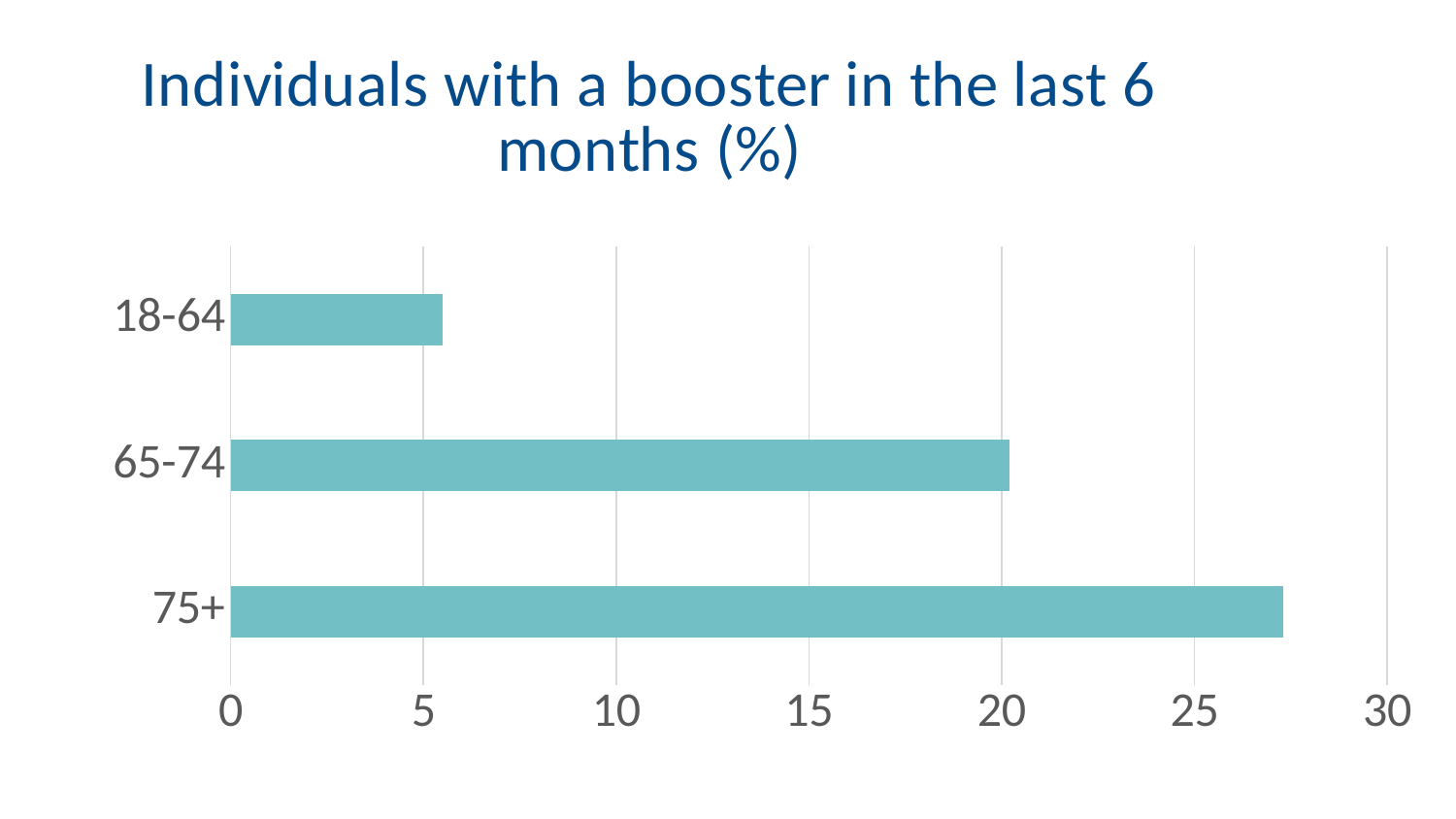
Which age group has a larger value, 75+ or 65-74? 75+ What kind of chart is shown on the slide? bar chart Which age group has a larger value, 65-74 or 18-64? 65-74 Is the value for the 18-64 age group greater or less than 10? less What is the title of the chart? Individuals with a booster in the last 6 months (%) Which age group has the lowest percentage of individuals with a booster in the last 6 months? 18-64 How many age groups are shown in the chart? 3 Is the value for the 65-74 age group greater or less than 15? greater Which age group has the highest percentage of individuals with a booster in the last 6 months? 75+ Is the value for the 75+ age group greater or less than 25? greater What is the maximum value shown on the horizontal axis? 30